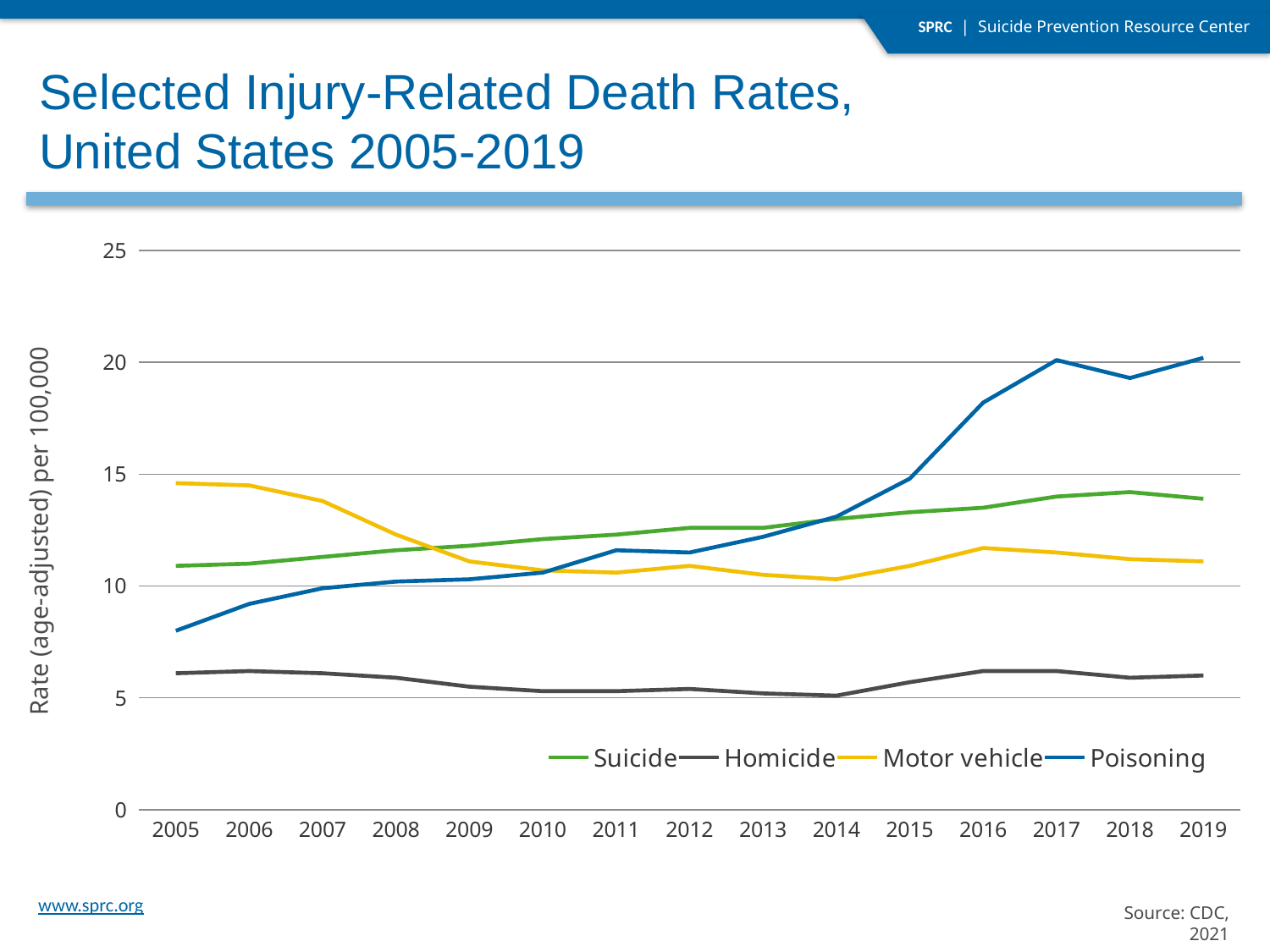
What kind of chart is shown on the slide? Line chart How many years are shown along the x axis? 15 Does the Poisoning rate rise or fall from 2005 to 2019? rise In 2019, which is higher: the Poisoning rate or the Suicide rate? Poisoning Is the Motor vehicle rate in 2005 greater or less than 10? greater How many series does the legend list? 4 Is the Poisoning rate in 2005 greater or less than 10? less Which series has the lowest rate in 2010? Homicide Is the Suicide rate in 2019 greater or less than 15? less Which series has the highest rate in 2019? Poisoning In 2005, which is higher: the Motor vehicle rate or the Poisoning rate? Motor vehicle